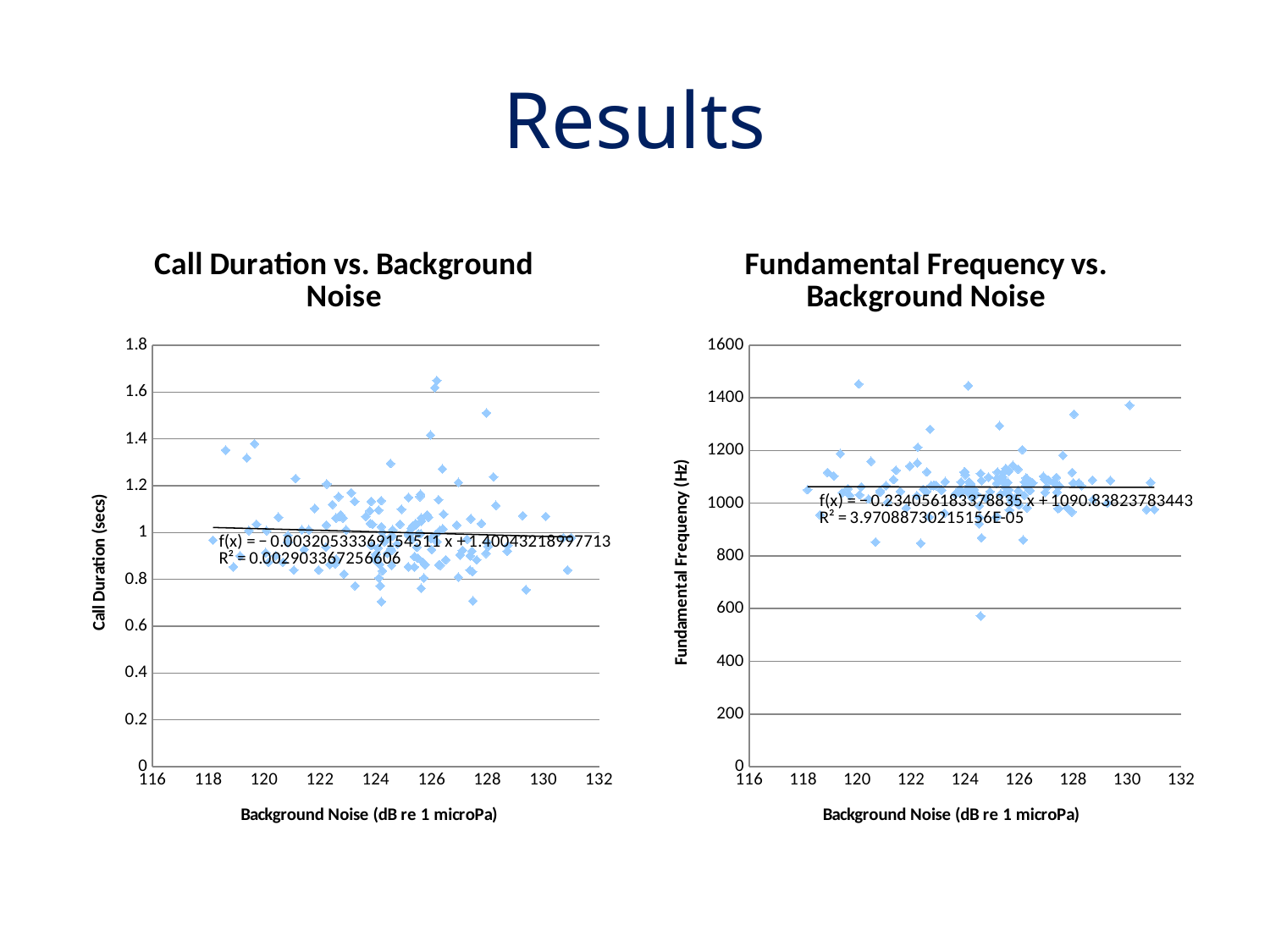
In the 'Call Duration vs. Background Noise' chart, is the highest plotted point greater or less than 1.4? greater What is the x-axis title of the 'Call Duration vs. Background Noise' chart? Background Noise (dB re 1 microPa) In the 'Call Duration vs. Background Noise' chart, does the fitted trendline rise or fall as background noise increases? Falls In the 'Call Duration vs. Background Noise' chart, what is the R² value printed on the chart? 0.002903367256606 In the 'Fundamental Frequency vs. Background Noise' chart, is the lowest plotted point greater or less than 600? less In the 'Fundamental Frequency vs. Background Noise' chart, what is the R² value printed on the chart? 3.97088730215156E-05 In the 'Fundamental Frequency vs. Background Noise' chart, what is the trendline equation printed on the chart? f(x) = − 0.234056183378835 x + 1090.83823783443 What kind of chart is the 'Call Duration vs. Background Noise' chart? Scatter chart Which chart has the larger R² value, 'Call Duration vs. Background Noise' or 'Fundamental Frequency vs. Background Noise'? Call Duration vs. Background Noise What kind of chart is the 'Fundamental Frequency vs. Background Noise' chart? Scatter chart In the 'Fundamental Frequency vs. Background Noise' chart, does the fitted trendline rise or fall as background noise increases? Falls In the 'Call Duration vs. Background Noise' chart, what is the trendline equation printed on the chart? f(x) = − 0.00320533369154511 x + 1.40043218997713